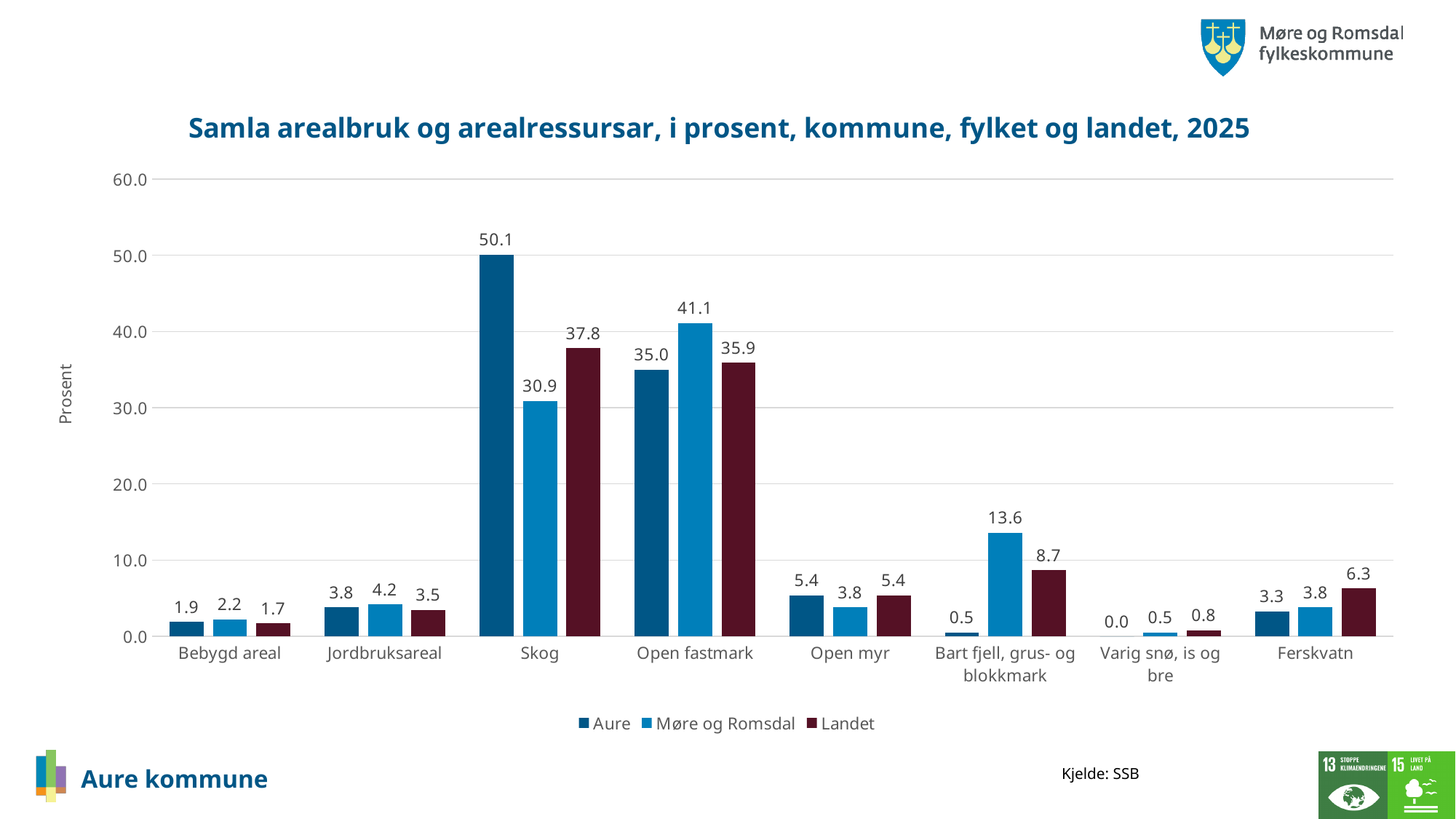
What is the title of the chart? Samla arealbruk og arealressursar, i prosent, kommune, fylket og landet, 2025 How many categories are shown on the x axis? 8 How many series does the legend list? 3 What is the value for Aure in the Skog category? 50.1 What kind of chart is shown on the slide? Bar chart What is the label of the y axis? Prosent What is the value for Landet in the Ferskvatn category? 6.3 Which is larger for Open fastmark: the value for Aure or the value for Landet? Landet What is the difference between the Aure and Møre og Romsdal values for Skog? 19.2 Which category has the highest value for Aure? Skog Which category has the lowest value for Møre og Romsdal? Varig snø, is og bre What is the value for Møre og Romsdal in the Bart fjell, grus- og blokkmark category? 13.6